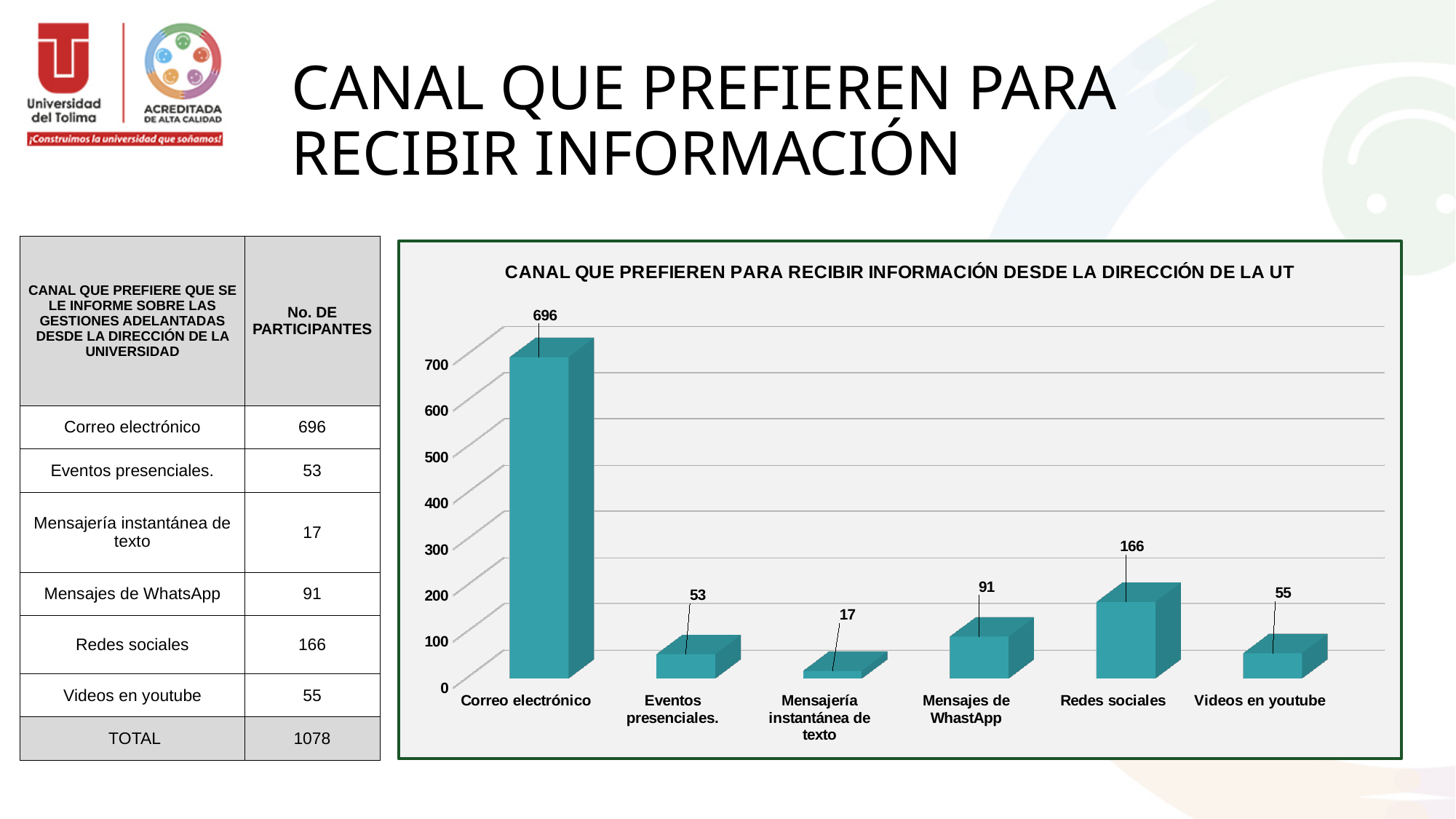
What is the value for Redes sociales in the chart? 166 Is the value for Redes sociales greater or less than 200? less How many categories are shown in the chart? 6 What is the value for Mensajería instantánea de texto in the chart? 17 Which is larger, the value for Eventos presenciales. or the value for Videos en youtube? Videos en youtube Which category has the lowest value in the chart? Mensajería instantánea de texto Which category has the highest value in the chart? Correo electrónico What is the title of the chart? CANAL QUE PREFIEREN PARA RECIBIR INFORMACIÓN DESDE LA DIRECCIÓN DE LA UT What is the difference between the values for Mensajes de WhatsApp and Videos en youtube? 36 What is the value for Correo electrónico in the chart? 696 What is the difference between the values for Correo electrónico and Redes sociales? 530 What kind of chart is shown on the slide? bar chart